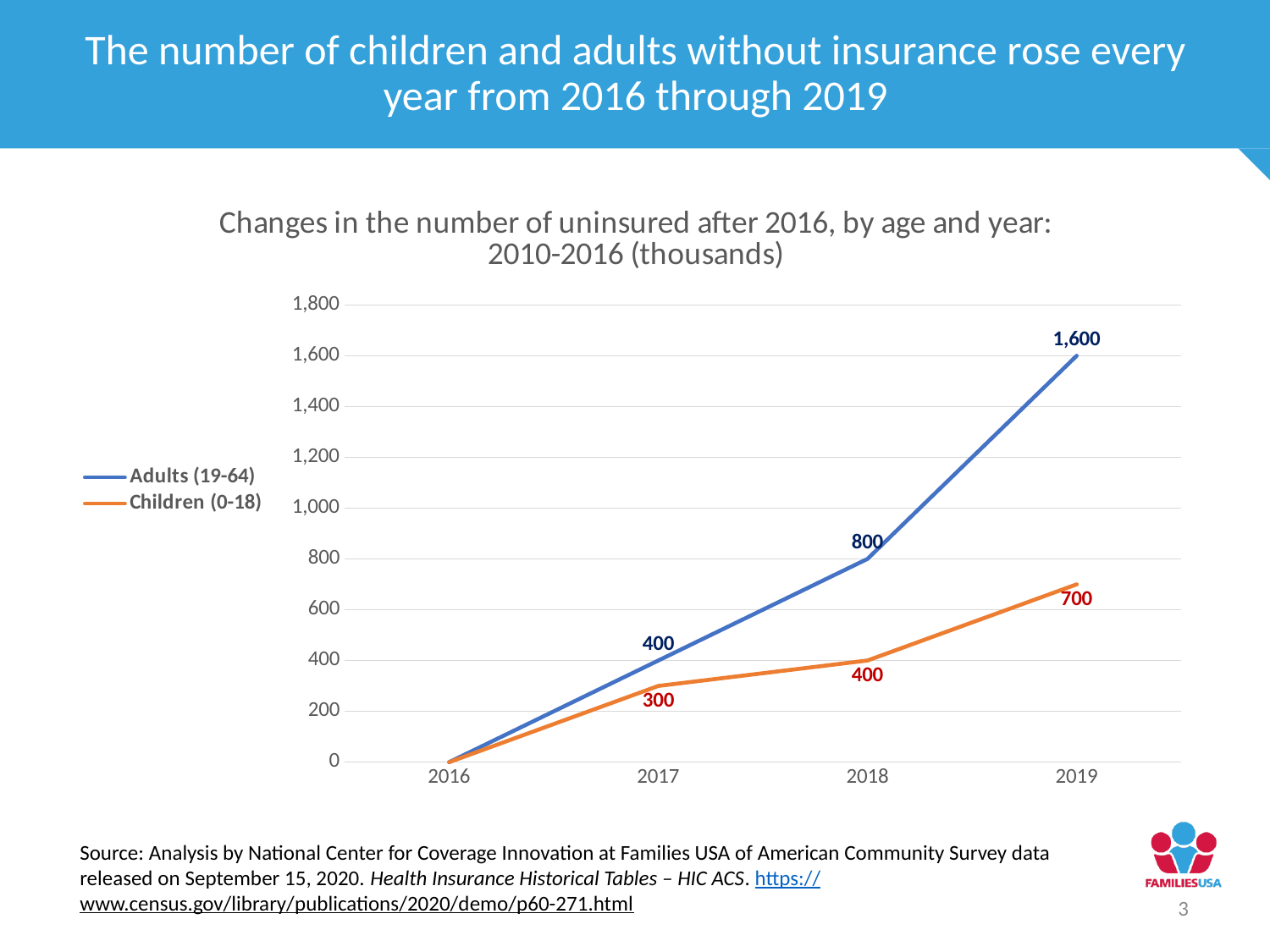
In which year is the value for Adults (19-64) highest? 2019 What is the difference between the Adults (19-64) and Children (0-18) values in 2019? 900 What is the value for Children (0-18) in 2019? 700 What is the value for Children (0-18) in 2018? 400 How many series does the legend list? 2 Which is larger in 2018, the value for Adults (19-64) or for Children (0-18)? Adults (19-64) What is the difference between the Adults (19-64) values in 2018 and 2017? 400 Does the Children (0-18) line rise or fall from 2016 to 2019? rise How many years are shown on the x axis? 4 What type of chart is shown on the slide? line chart What is the value for Adults (19-64) in 2019? 1,600 What is the value for Adults (19-64) in 2017? 400